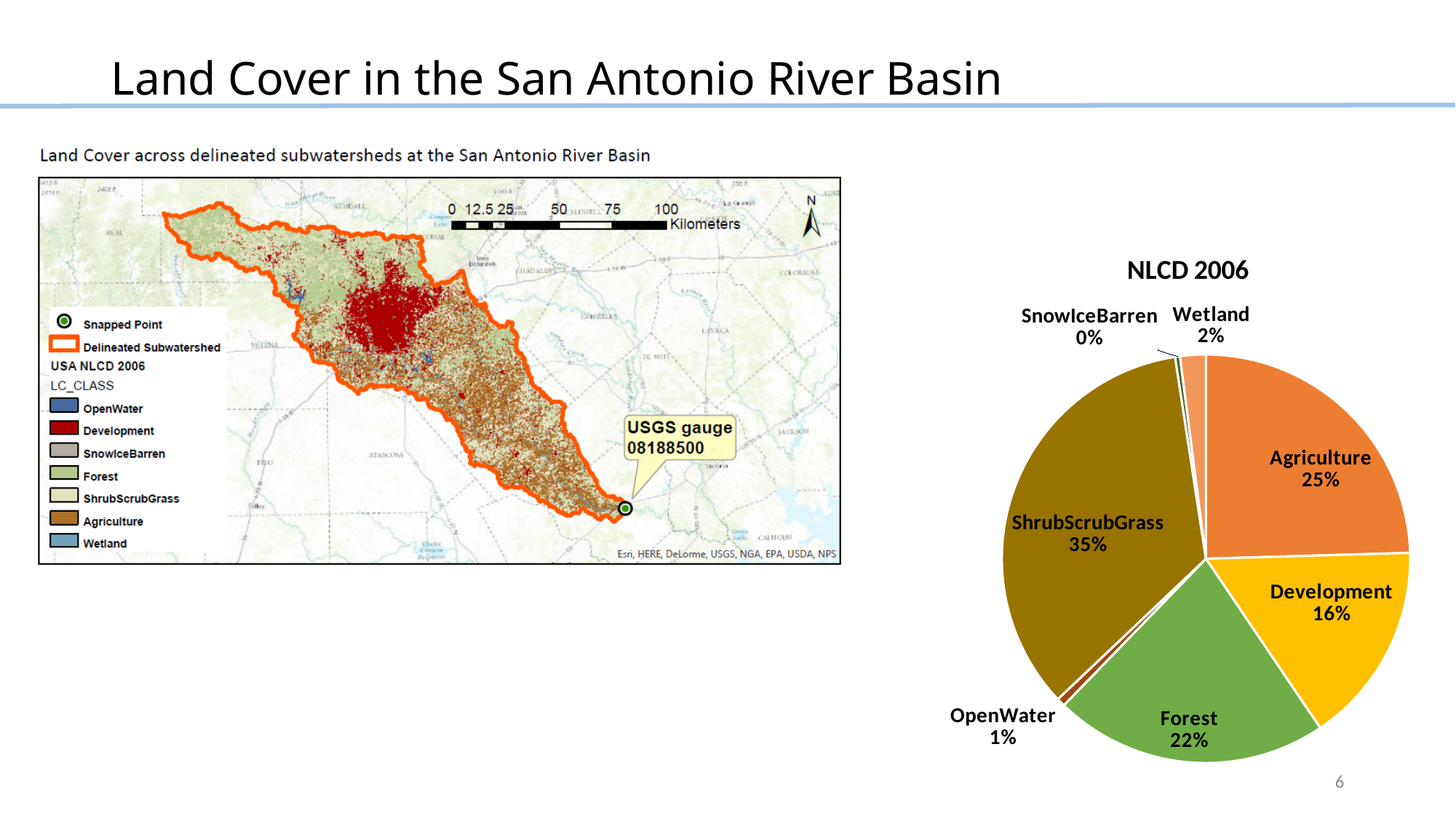
What is the difference between the Agriculture and Development shares? 9% Which land cover class has the smallest slice of the pie? SnowIceBarren What is the value for Wetland in the pie chart? 2% What share of the pie does Agriculture have? 25% What is the title of the pie chart? NLCD 2006 What type of chart is the NLCD 2006 chart? pie chart How many land cover classes are shown in the pie chart? 7 What is the value for Development in the pie chart? 16% What is the value for Forest in the pie chart? 22% What share of the pie does ShrubScrubGrass have? 35% Which is larger in the pie chart, Forest or Development? Forest Which land cover class has the largest slice of the pie? ShrubScrubGrass